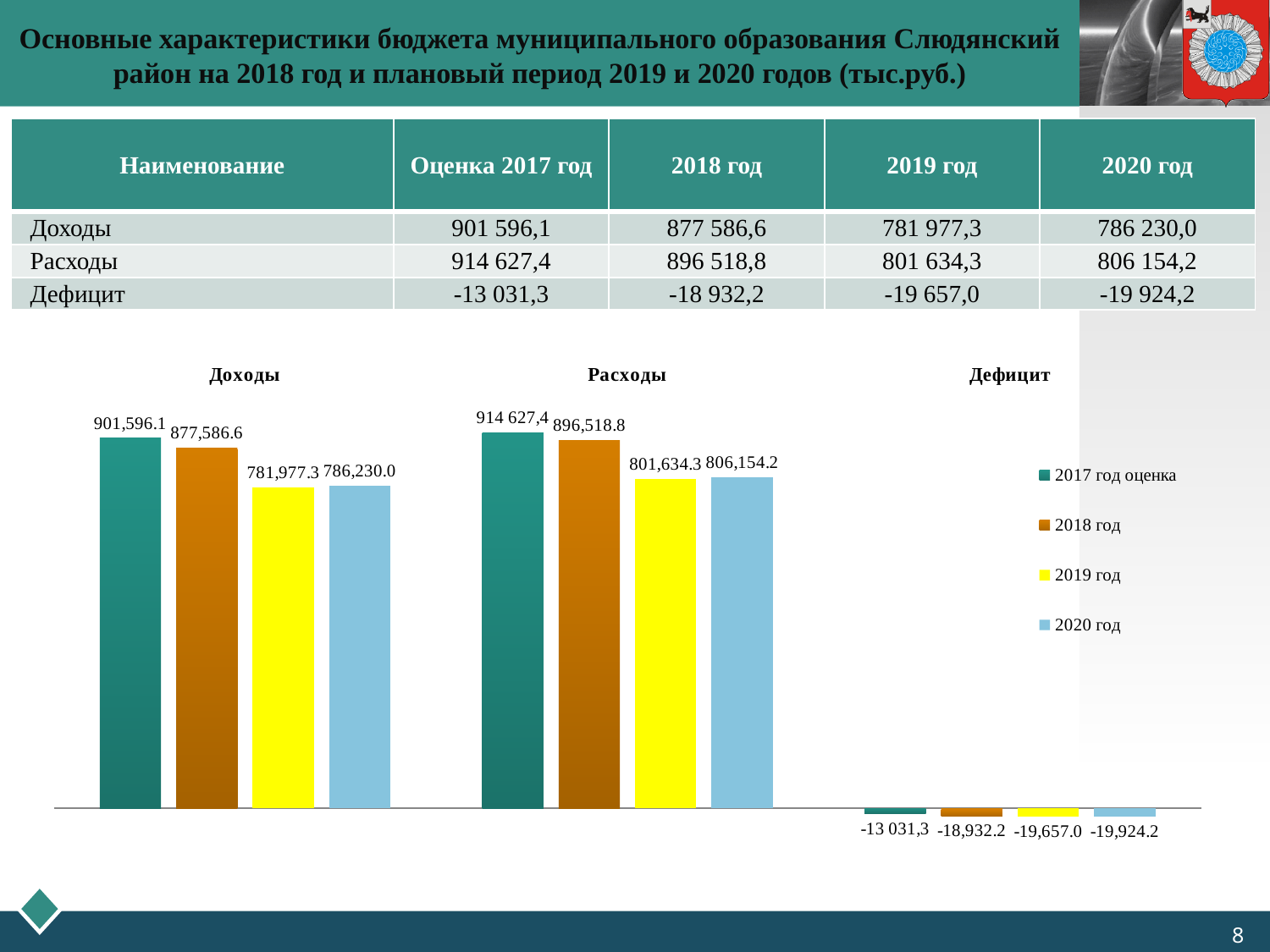
What is the value of Доходы for 2017 год оценка in the chart? 901,596.1 How many category groups (Доходы, Расходы, Дефицит) are plotted in the chart? 3 Do the Доходы values rise or fall from 2017 год оценка to 2019 год in the chart? fall What kind of chart is shown on the slide? bar chart Which year has the lowest Доходы value in the chart? 2019 год What is the difference between Расходы and Доходы for 2018 год in the chart? 18,932.2 In the chart, which is larger: Расходы for 2019 год or Расходы for 2020 год? 2020 год What is the value of Дефицит for 2020 год in the chart? -19,924.2 Which colour represents 2019 год in the chart legend? yellow What is the value of Расходы for 2019 год in the chart? 801,634.3 How many series does the chart legend list? 4 Which year has the highest Расходы bar in the chart? 2017 год оценка